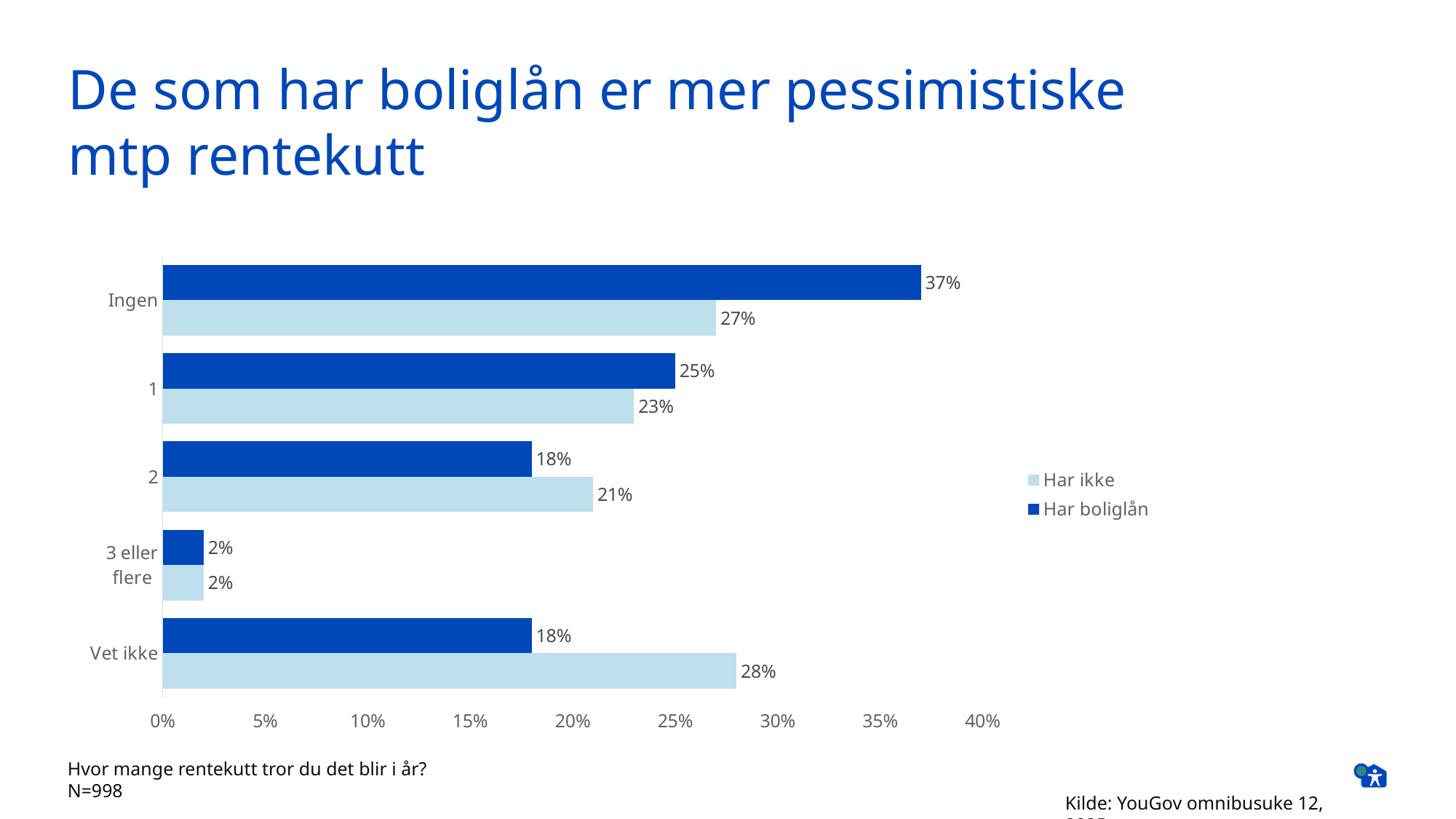
What is the value for 'Har ikke' in the '2' category? 21% What kind of chart is shown on the slide? bar chart What is the value for 'Har boliglån' in the 'Ingen' category? 37% How many categories are shown on the chart? 5 In the 'Vet ikke' category, which series has the larger value, 'Har ikke' or 'Har boliglån'? Har ikke Is the value for 'Har boliglån' in the '1' category greater or less than 20%? greater How many series does the legend list? 2 What is the value for 'Har ikke' in the 'Vet ikke' category? 28% What are the two series listed in the legend? Har ikke, Har boliglån Which category has the lowest value for 'Har ikke'? 3 eller flere Which category has the highest value for 'Har boliglån'? Ingen What is the difference between 'Har boliglån' and 'Har ikke' in the 'Ingen' category? 10%